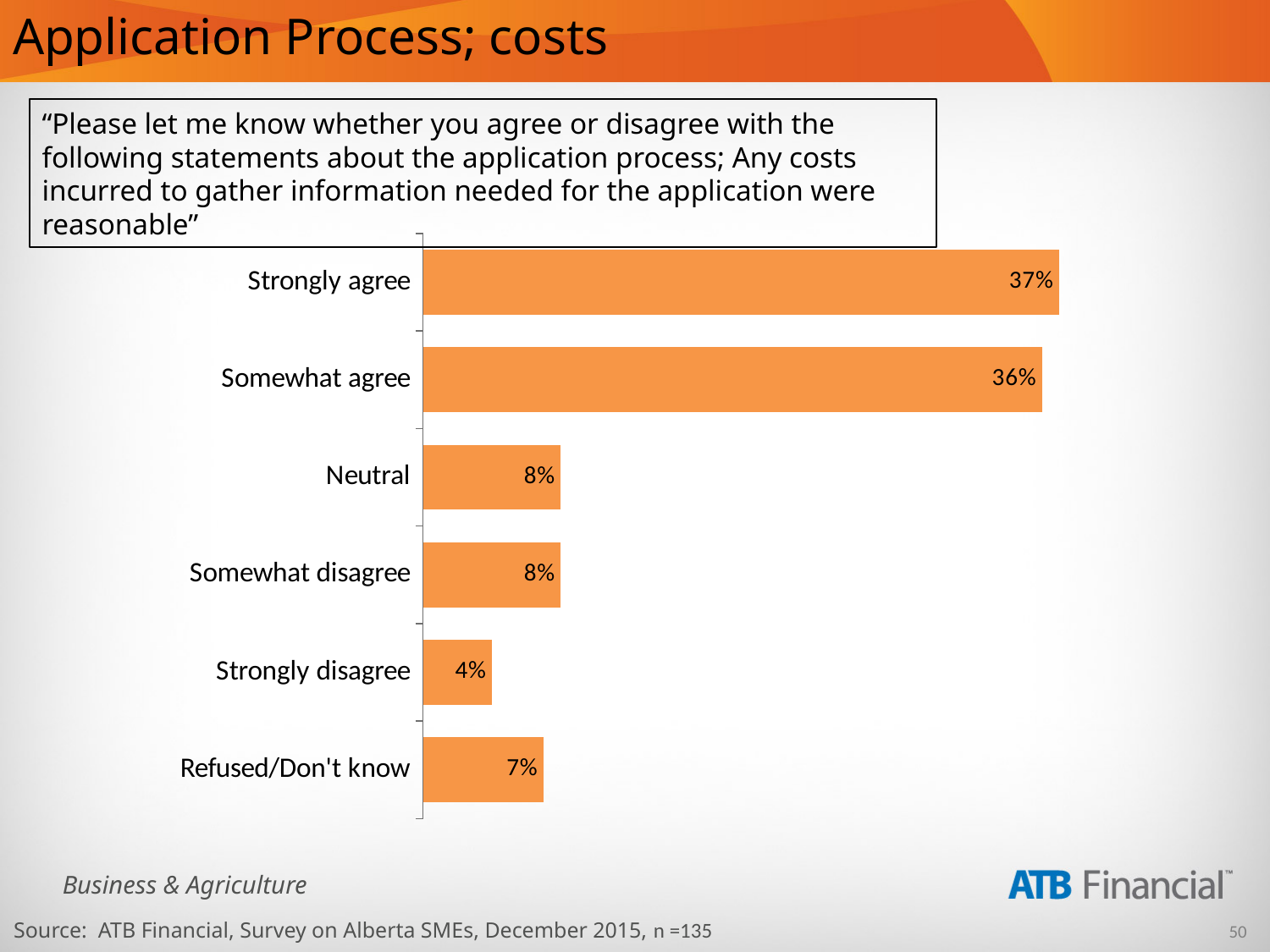
What is the value shown for "Strongly disagree"? 4% What is the combined value of "Strongly agree" and "Somewhat agree"? 73% What kind of chart is shown on the slide? Bar chart What percentage of respondents answered "Refused/Don't know"? 7% Which is larger, the value for "Refused/Don't know" or the value for "Strongly disagree"? Refused/Don't know How many response categories are shown in the chart? 6 What is the difference between the "Strongly agree" and "Somewhat agree" values? 1% Which response category has the lowest value? Strongly disagree What is the difference between the "Neutral" and "Strongly disagree" values? 4% What is the value shown for "Somewhat agree"? 36% What percentage of respondents answered "Strongly agree"? 37% Which response category has the highest value? Strongly agree